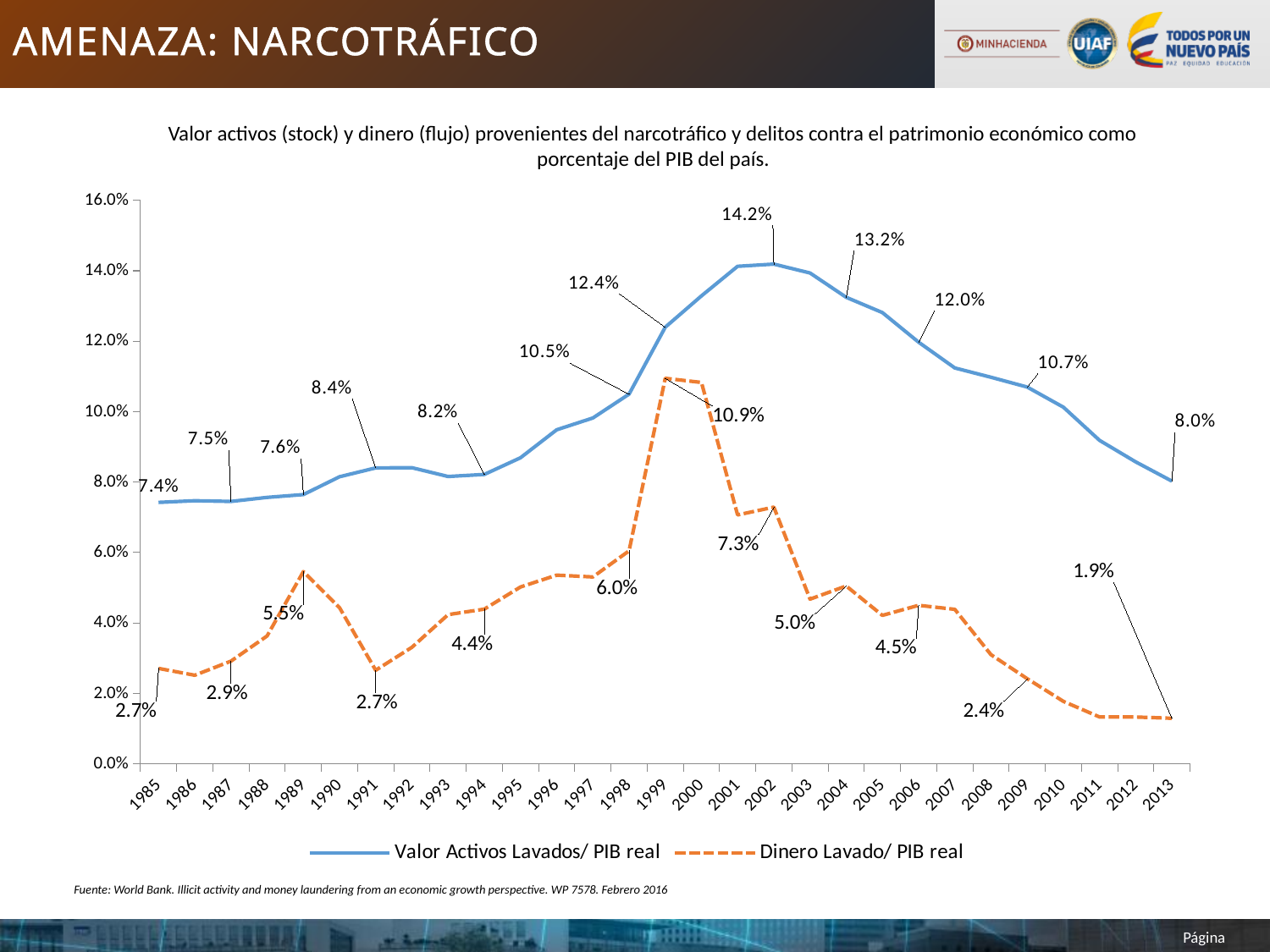
In 1989, which series has the larger value: Valor Activos Lavados/ PIB real or Dinero Lavado/ PIB real? Valor Activos Lavados/ PIB real What is the value of Valor Activos Lavados/ PIB real in 1985? 7.4% How many years are shown on the x axis? 29 Does Valor Activos Lavados/ PIB real rise or fall between 2002 and 2013? Fall What is the value of Valor Activos Lavados/ PIB real in 2002? 14.2% Which series is drawn as a dashed orange line? Dinero Lavado/ PIB real How many series does the legend list? 2 In which year does Valor Activos Lavados/ PIB real reach its highest value? 2002 What is the value of Dinero Lavado/ PIB real in 2000? 10.9% What type of chart is shown on the slide? Line chart What is the difference between Valor Activos Lavados/ PIB real and Dinero Lavado/ PIB real in 2002? 6.9 percentage points Is the value of Valor Activos Lavados/ PIB real in 1995 greater or less than 10.0%? less